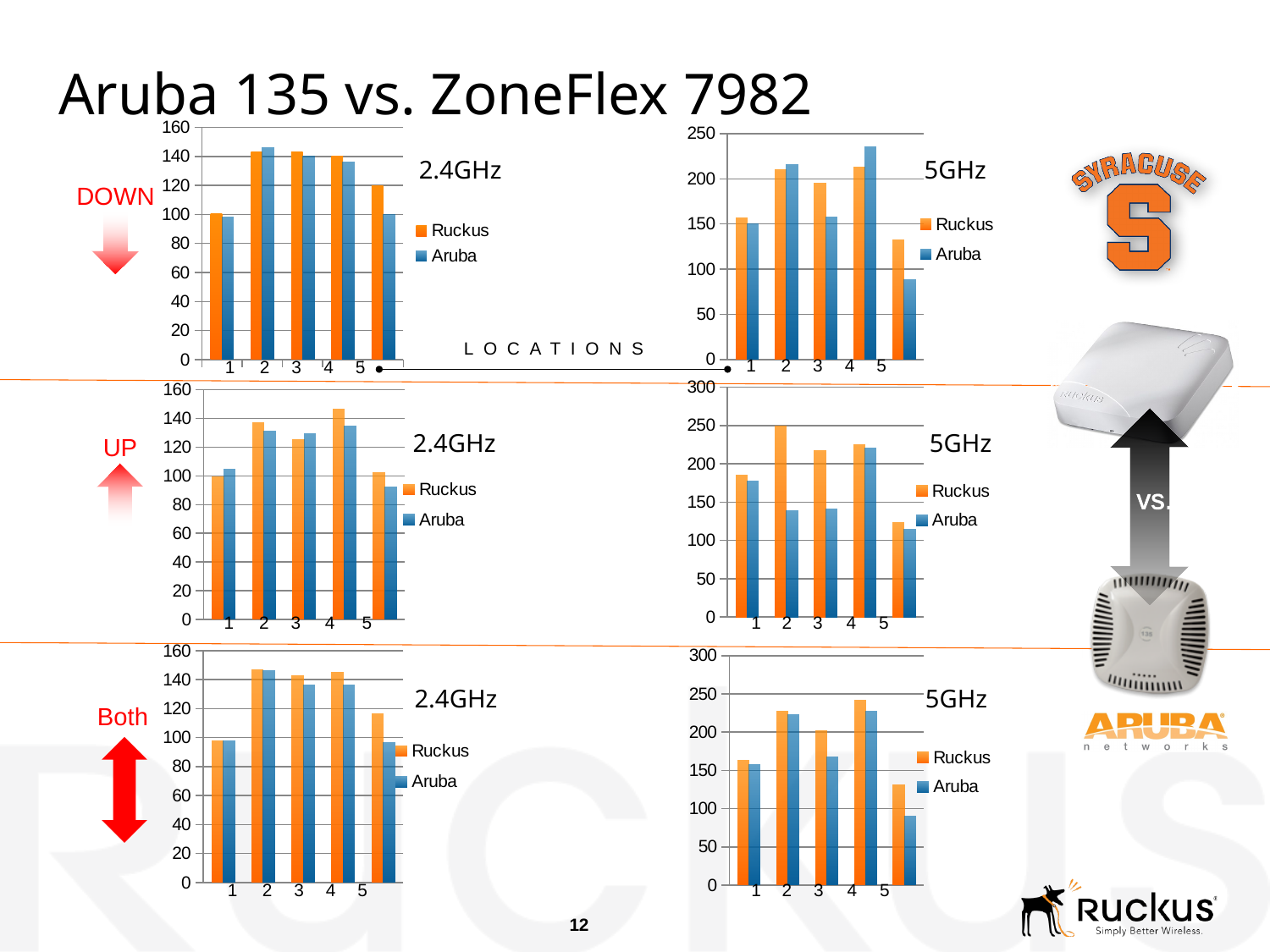
In the DOWN 2.4GHz chart (top left), how many locations are plotted on the x axis? 5 What are the two legend entries in the Both 5GHz chart (bottom right)? Ruckus and Aruba In the DOWN 5GHz chart (top right), how many series does the legend list? 2 In the UP 5GHz chart (middle right), which is larger at location 2, Ruckus or Aruba? Ruckus In the UP 2.4GHz chart (middle left), at which location is the Ruckus value highest? 4 In the Both 5GHz chart (bottom right), at which location is the Ruckus value lowest? 5 In the DOWN 2.4GHz chart (top left), which is larger at location 5, Ruckus or Aruba? Ruckus In the Both 2.4GHz chart (bottom left), which is larger at location 5, Ruckus or Aruba? Ruckus What kind of chart is the UP 2.4GHz chart (middle left)? bar chart In the DOWN 5GHz chart (top right), at which location is the Aruba value highest? 4 In the UP 5GHz chart (middle right), is the Aruba value at location 2 greater or less than 150? less In the DOWN 5GHz chart (top right), is the Aruba value at location 5 greater or less than 100? less